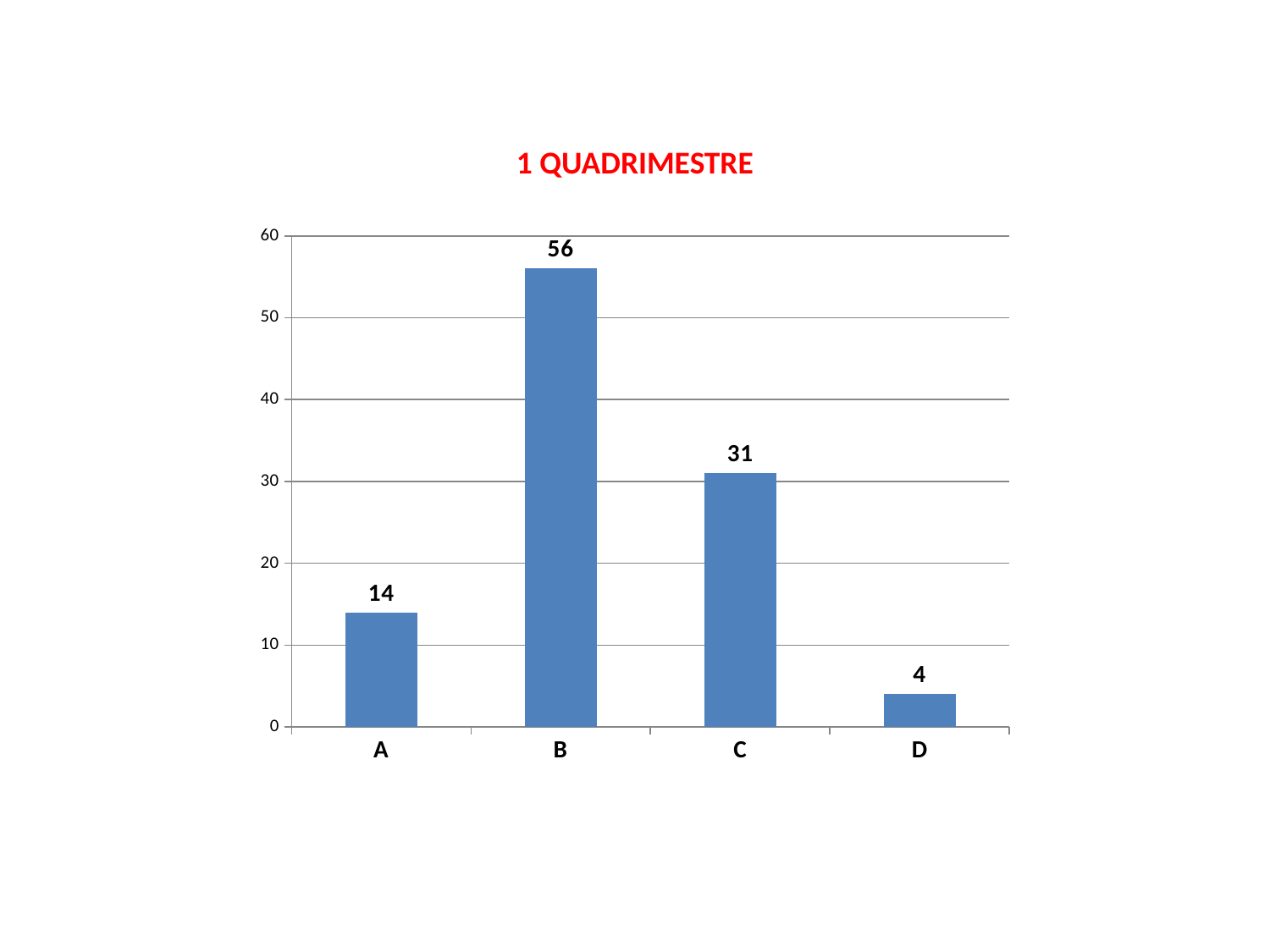
What is the value for category D? 4 Which category has the lowest value? D What is the value for category A? 14 What is the difference between the values for A and D? 10 What is the difference between the values for B and C? 25 What kind of chart is shown on the slide? bar chart Is the value for C greater or less than 40? less What is the value for category B? 56 Which category has the highest value? B How many categories are shown on the x axis? 4 What is the title of the chart? 1 QUADRIMESTRE Which is larger, the value for A or the value for C? C